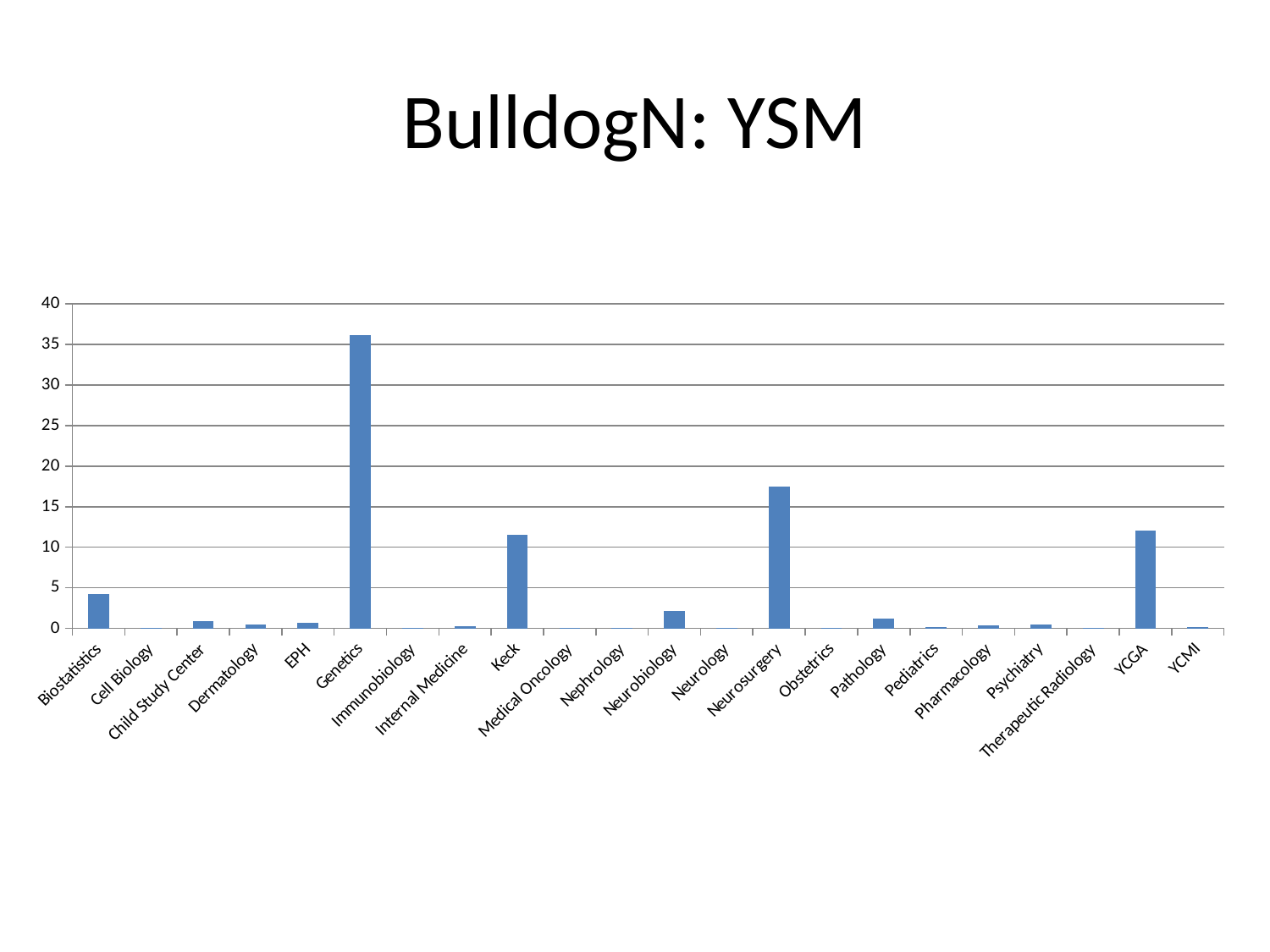
Is the value for Neurosurgery greater or less than 15? greater Which is larger, the value for Neurosurgery or the value for Keck? Neurosurgery Which category has the highest value? Genetics Which is larger, the value for Biostatistics or the value for Neurobiology? Biostatistics Is the value for Keck greater or less than 10? greater How many categories are shown on the x axis? 22 Which is larger, the value for Genetics or the value for YCGA? Genetics Is the value for Genetics greater or less than 35? greater What kind of chart is shown on the slide? bar chart What is the title of the slide? BulldogN: YSM